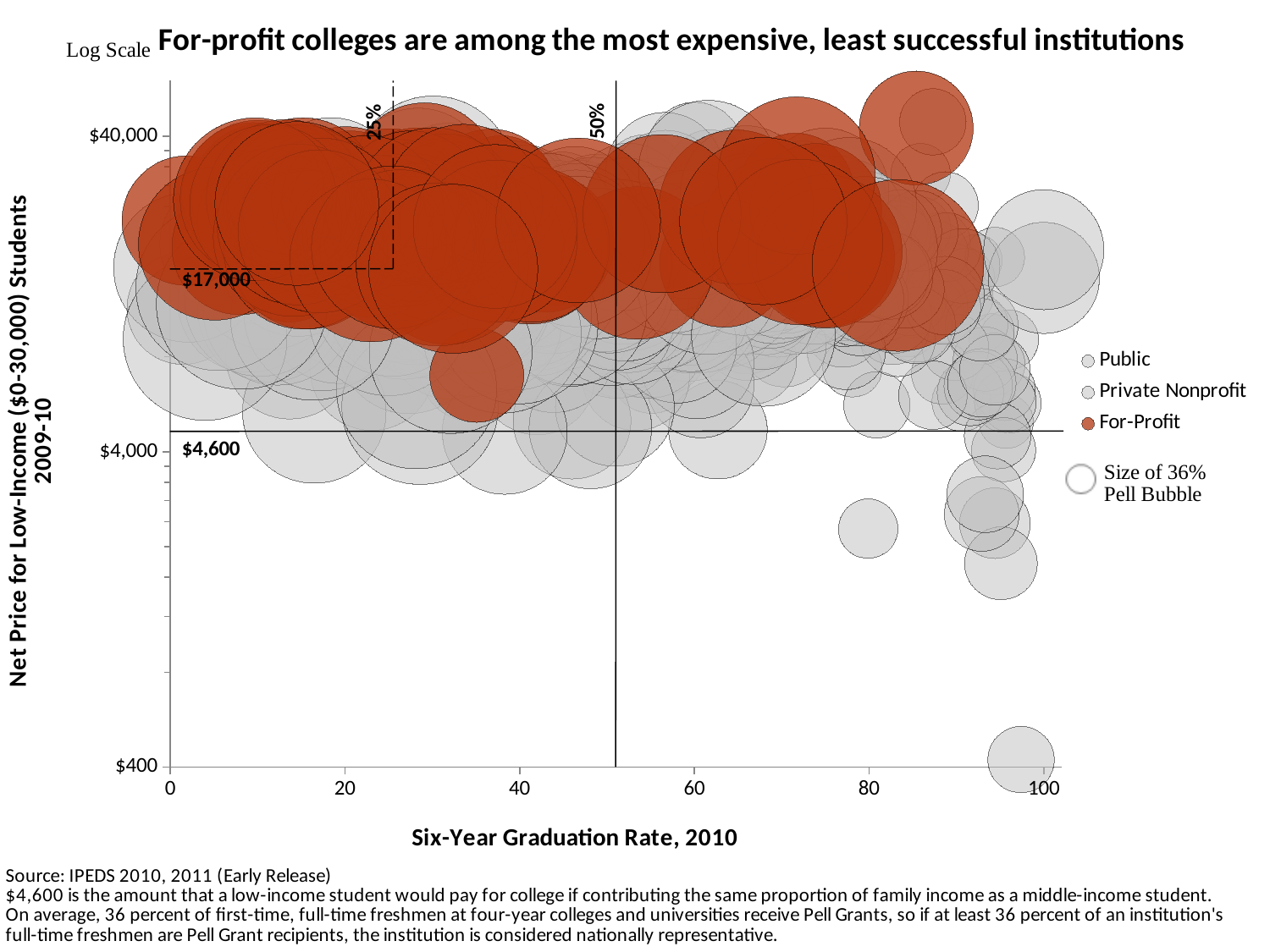
What net price does the dashed horizontal reference line mark? $17,000 How many institution types does the legend list? 3 What net price does the solid horizontal reference line mark? $4,600 What is the maximum value shown on the x axis? 100 What graduation rate does the dashed vertical reference line mark? 25% What graduation rate does the solid vertical reference line mark? 50% Which colour represents For-Profit institutions in the chart? Red What is the title of the chart? For-profit colleges are among the most expensive, least successful institutions What Pell Grant percentage does the reference bubble in the legend represent? 36% What is the lowest value labelled on the y axis? $400 What kind of chart is shown on the slide? Bubble chart What is the highest value labelled on the y axis? $40,000